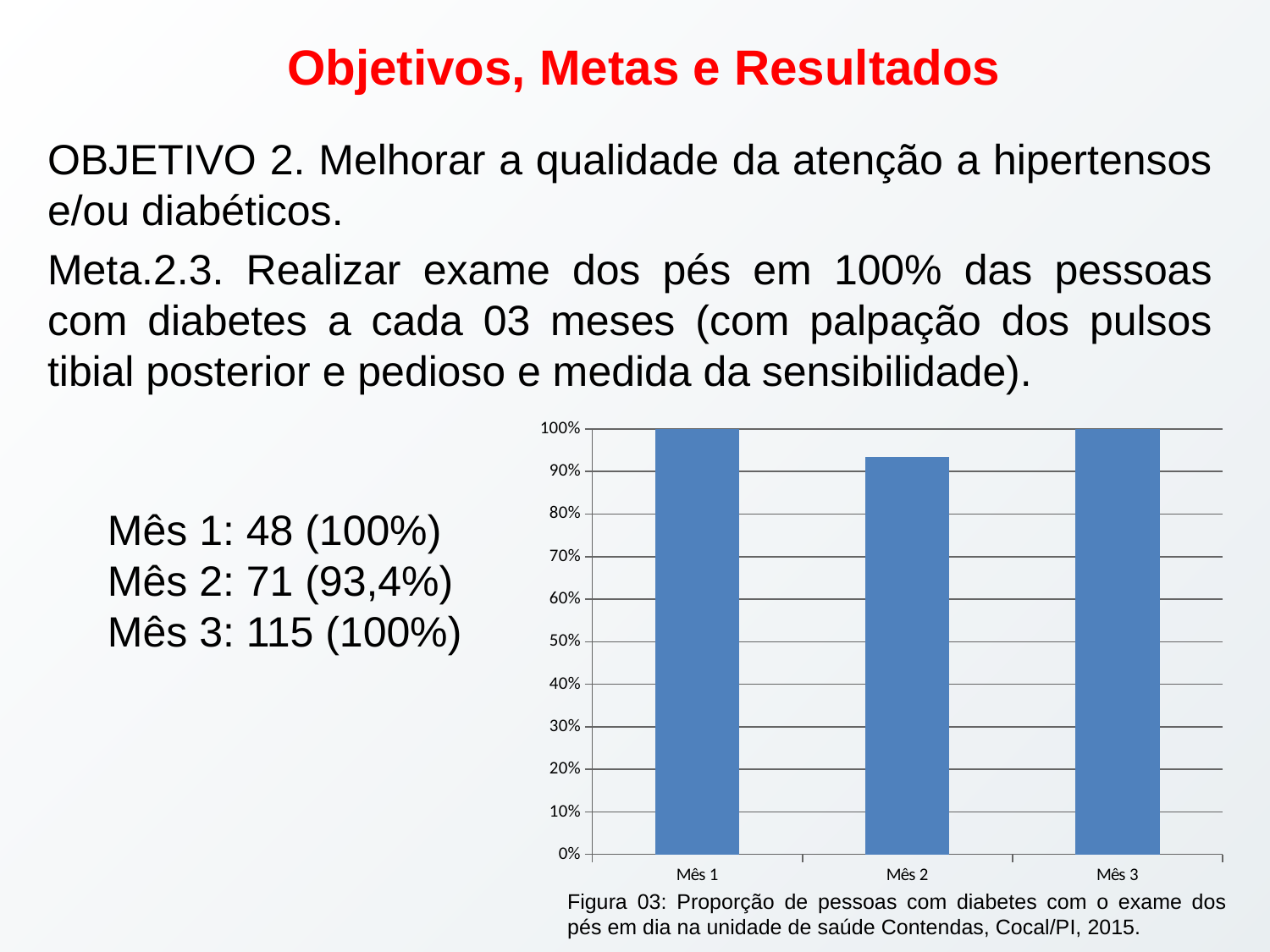
Which is larger, the value for Mês 1 or the value for Mês 2? Mês 1 Which month has the lowest value in the chart? Mês 2 Is the value for Mês 2 greater or less than 100%? less Does the value rise or fall from Mês 1 to Mês 2? fall What is the value for Mês 1 in the chart? 100% Does the value rise or fall from Mês 2 to Mês 3? rise What colour are the bars in the chart? blue How many months (categories) are plotted in the chart? 3 Is the value for Mês 2 greater or less than 90%? greater What kind of chart is shown on the slide? bar chart What is the value for Mês 3 in the chart? 100% Which is larger, the value for Mês 3 or the value for Mês 2? Mês 3